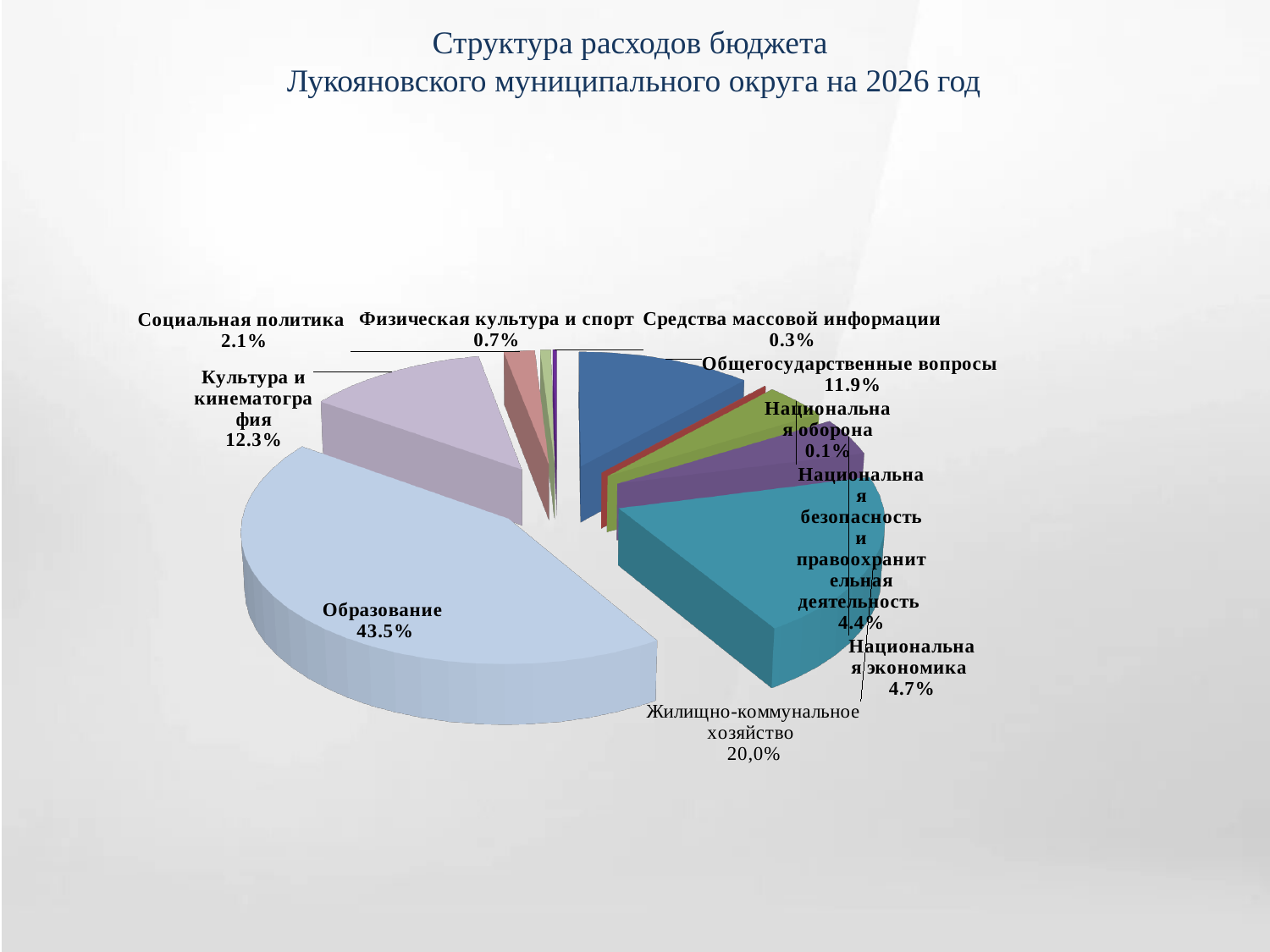
What share of the budget expenditure goes to Образование? 43.5% What type of chart is shown on the slide? Pie chart What percentage is shown for Национальная оборона? 0.1% What is the title of the chart on the slide? Структура расходов бюджета Лукояновского муниципального округа на 2026 год What percentage is labelled for Общегосударственные вопросы? 11.9% What share is shown for Жилищно-коммунальное хозяйство? 20,0% What share is shown for Культура и кинематография? 12.3% Which category has the largest share of the pie? Образование Which category has the smallest share of the pie? Национальная оборона How many categories are shown in the pie chart? 10 Which is larger: Национальная экономика or Национальная безопасность и правоохранительная деятельность? Национальная экономика What is the difference between the shares of Культура и кинематография and Общегосударственные вопросы? 0.4%